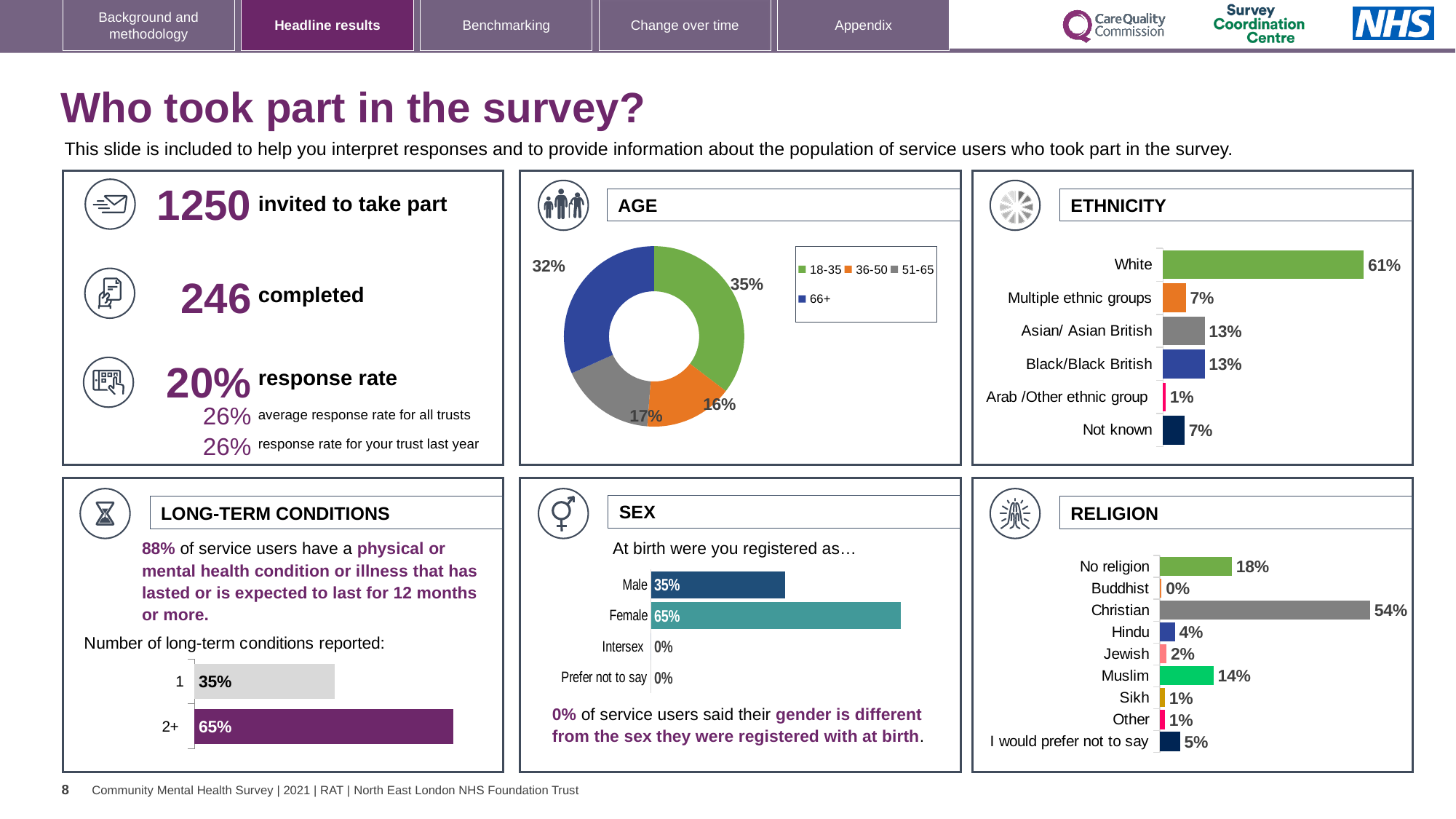
In the RELIGION chart, which is larger, No religion or Muslim? No religion How many entries does the legend of the AGE chart list? 4 In the RELIGION chart, which category has the highest value? Christian In the ETHNICITY chart, what is the value for White? 61% In the SEX chart, what is the value for Female? 65% In the AGE chart, what share of respondents are aged 18-35? 35% In the LONG-TERM CONDITIONS chart, what is the value for 2+ conditions? 65% How many categories does the ETHNICITY chart show? 6 In the ETHNICITY chart, what is the difference between White and Black/Black British? 48% What kind of chart is the AGE chart? Doughnut chart In the ETHNICITY chart, which category has the lowest value? Arab /Other ethnic group In the AGE chart, which age group has the smallest share? 36-50